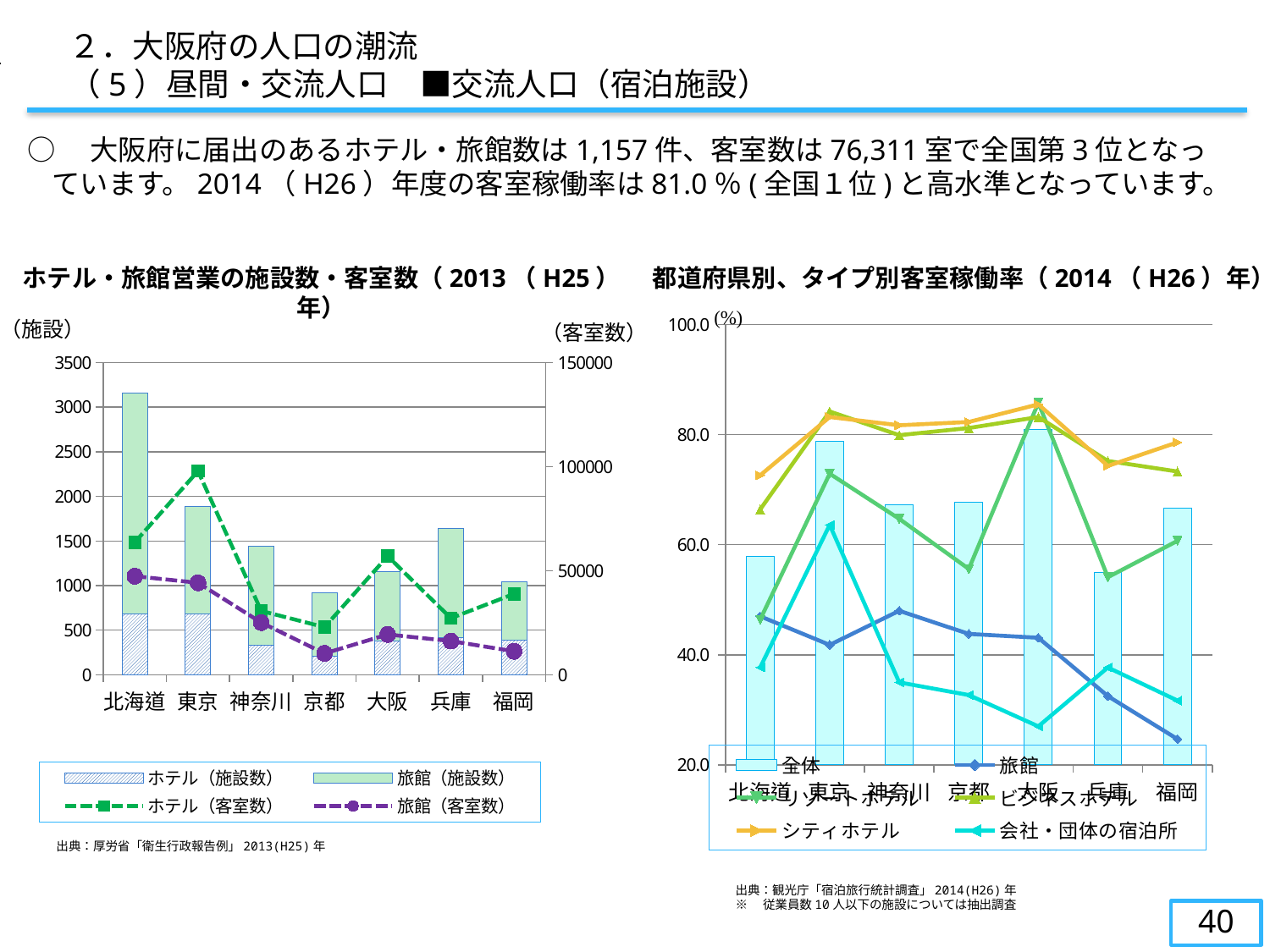
In the right chart (都道府県別、タイプ別客室稼働率), which prefecture has the tallest 全体 bar? 大阪 In the left chart (ホテル・旅館営業の施設数・客室数), is the total facilities bar for 東京 greater or less than 2000? less In the right chart (都道府県別、タイプ別客室稼働率), which prefecture has the lowest value on the 旅館 line? 福岡 In the right chart (都道府県別、タイプ別客室稼働率), how many series does the legend list? 6 In the right chart (都道府県別、タイプ別客室稼働率), which has the higher 全体 value, 東京 or 神奈川? 東京 In the left chart (ホテル・旅館営業の施設数・客室数), which prefecture has the tallest stacked bar for number of facilities? 北海道 In the left chart (ホテル・旅館営業の施設数・客室数), which prefecture has the shortest stacked bar for number of facilities? 京都 In the left chart (ホテル・旅館営業の施設数・客室数), how many series does the legend list? 4 In the left chart (ホテル・旅館営業の施設数・客室数), how many prefectures are shown on the x axis? 7 In the left chart (ホテル・旅館営業の施設数・客室数), is the ホテル（客室数） value for 東京 greater or less than 50000? greater In the left chart (ホテル・旅館営業の施設数・客室数), which prefecture has the highest value on the ホテル（客室数） line? 東京 In the right chart (都道府県別、タイプ別客室稼働率), is the 全体 value for 東京 greater or less than 60.0? greater